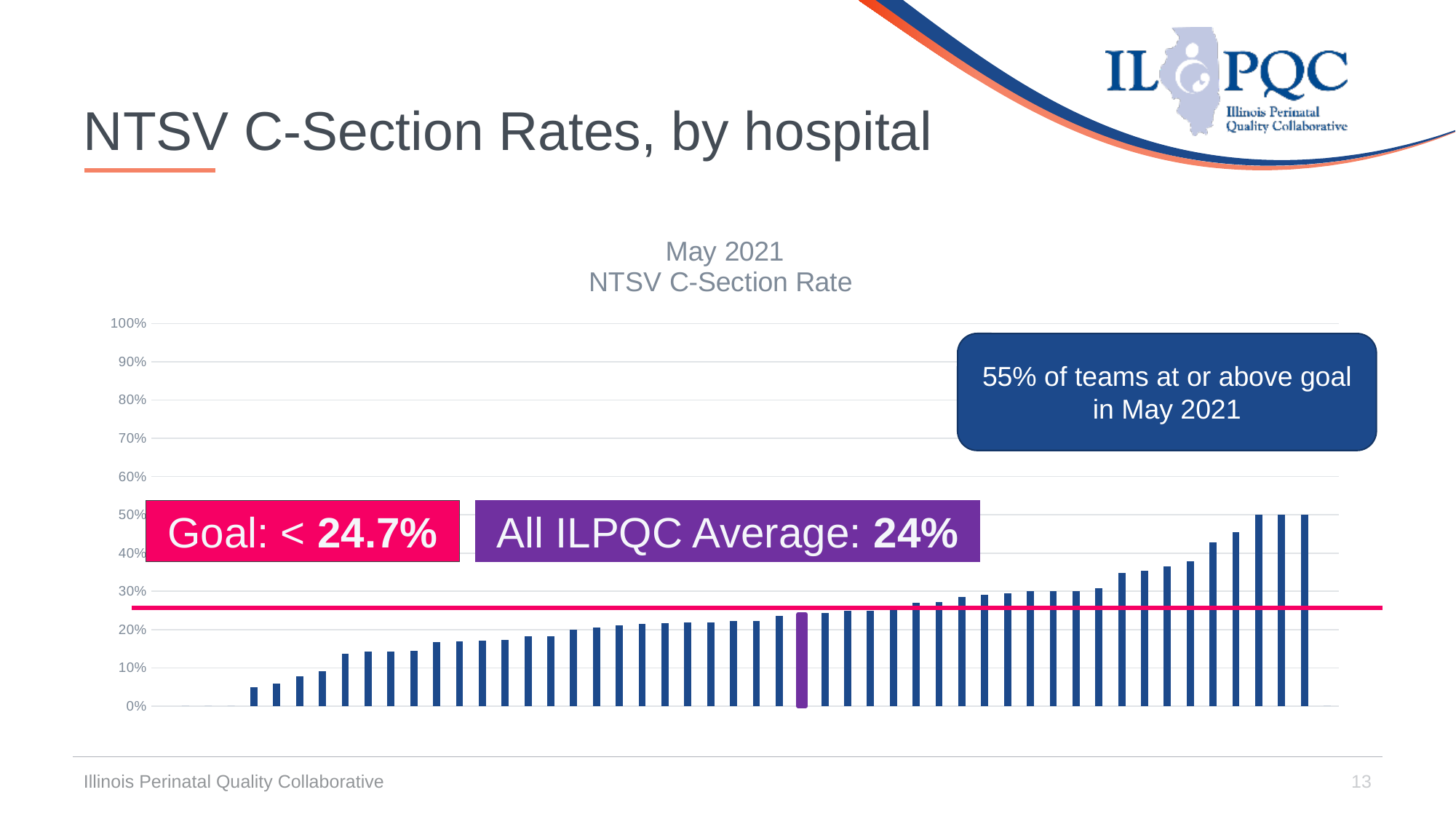
Is the value of the tallest bar greater or less than 60%? less Is the value of the purple highlighted bar greater or less than 30%? less What kind of chart is shown on the slide? bar chart What percentage of teams were at or above goal in May 2021, according to the chart callout? 55% What goal value is shown on the chart? < 24.7% Is the value of the tallest bar greater or less than 40%? greater Do the bar values rise or fall from left to right across the chart? rise What is the All ILPQC Average shown on the chart? 24% Is the All ILPQC Average greater or less than the goal of 24.7%? less What is the title of the chart? May 2021 NTSV C-Section Rate What colour is the bar that is highlighted differently from the others? purple